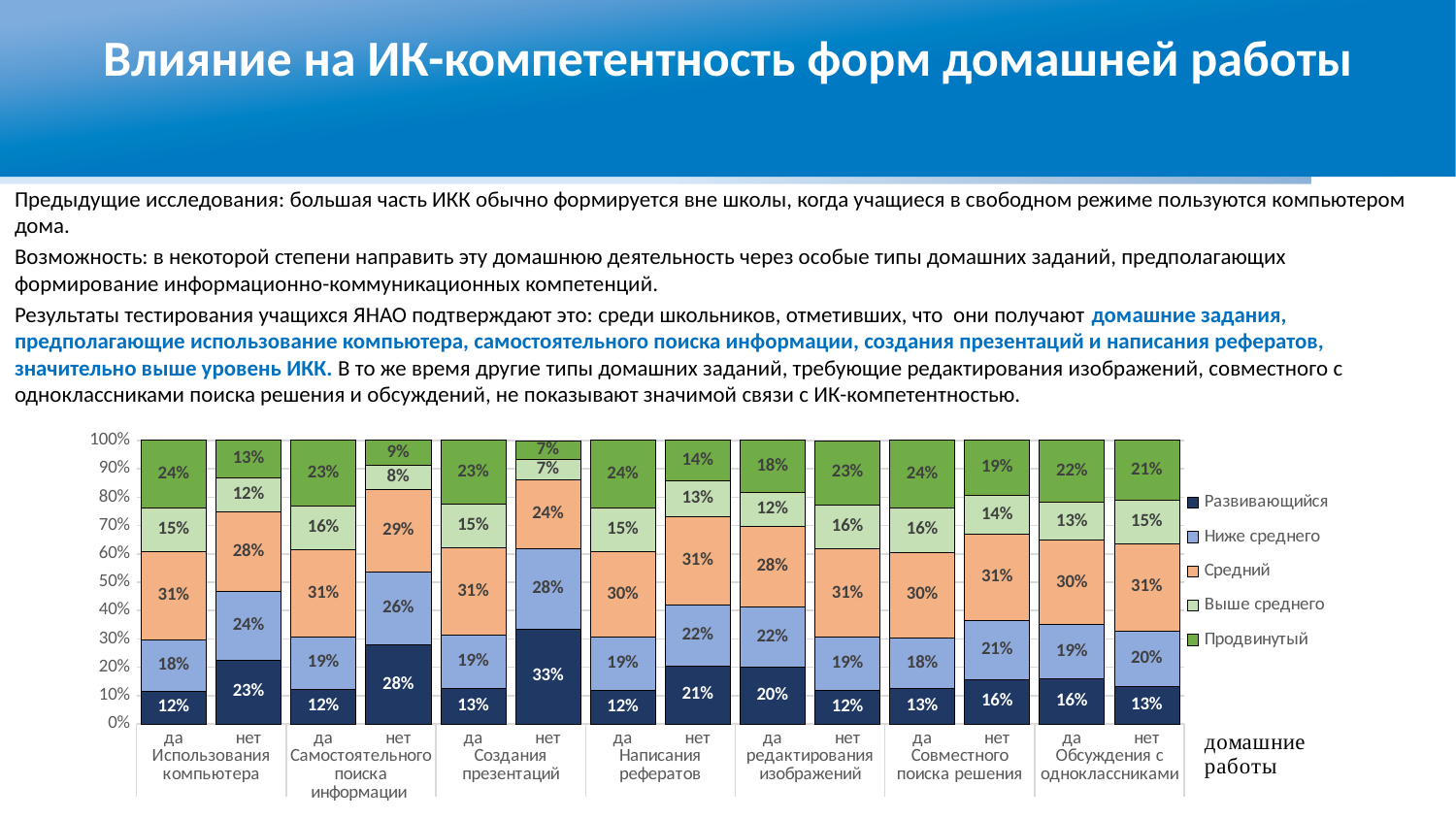
What is the value of the Средний segment for the 'нет' bar under Самостоятельного поиска информации? 29% Under Написания рефератов, which bar has the larger Развивающийся segment, 'да' or 'нет'? нет Which bar has the largest Развивающийся segment? нет, Создания презентаций How many series does the legend list? 5 What is the value of the Ниже среднего segment for the 'да' bar under редактирования изображений? 22% What kind of chart is shown on the slide? stacked bar chart Which legend entry is shown in dark blue? Развивающийся What is the value of the Продвинутый segment for the 'да' bar under Использования компьютера? 24% What is the difference between the Продвинутый values for 'да' and 'нет' under Самостоятельного поиска информации? 14% How many bars are plotted in the chart? 14 What is the value of the Развивающийся segment for the 'нет' bar under Создания презентаций? 33% Which bar has the smallest Продвинутый segment? нет, Создания презентаций